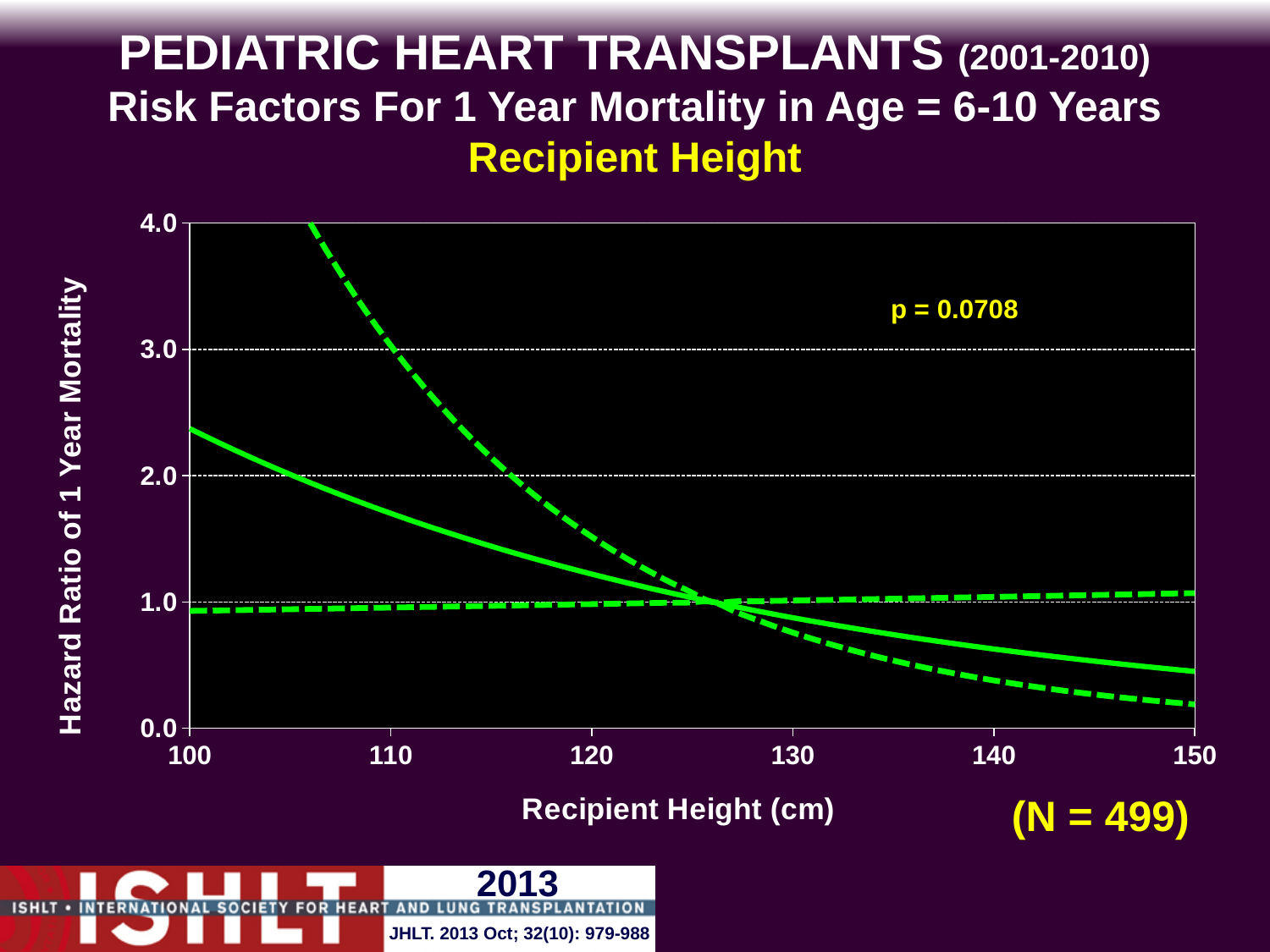
What is the sample size (N) shown on the slide? N = 499 Does the solid line rise or fall as recipient height increases from 100 cm to 150 cm? fall Is the value of the solid line at a recipient height of 150 cm greater or less than 1.0? less What is the p-value shown on the chart? p = 0.0708 Is the value of the upper dashed line at a recipient height of 120 cm greater or less than 2.0? less How many lines are plotted on the chart? 3 Is the value of the solid line at a recipient height of 100 cm greater or less than 2.0? greater At a recipient height of 110 cm, which is larger: the upper dashed line or the solid line? the upper dashed line Is the solid line's value larger at a recipient height of 100 cm or at 150 cm? 100 cm What kind of chart is shown on the slide? line chart